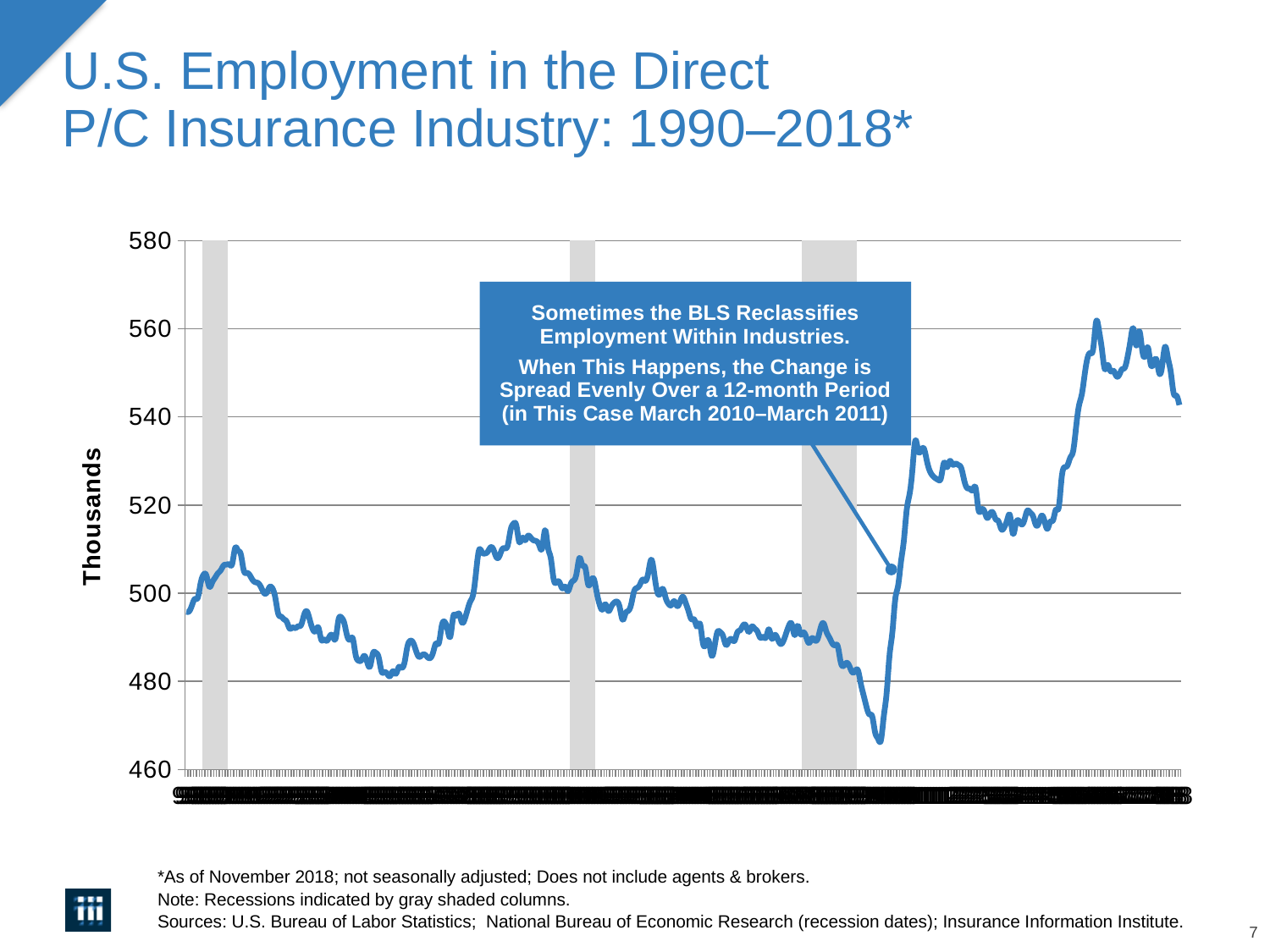
What kind of chart is shown on the slide? Line chart Is the value at the right end of the line (end of the period) greater or less than 540? greater Is the highest point on the line greater or less than 540? greater How many gray shaded recession columns appear on the chart? 3 Is the value at the left end of the line (start of the period) greater or less than 500? less What is the title of the chart on the slide? U.S. Employment in the Direct P/C Insurance Industry: 1990–2018* What is the highest value shown on the vertical axis? 580 What is the label on the vertical axis of the chart? Thousands How many lines are plotted on the chart? 1 Is the value at the right end of the line higher or lower than the value at the left end? higher